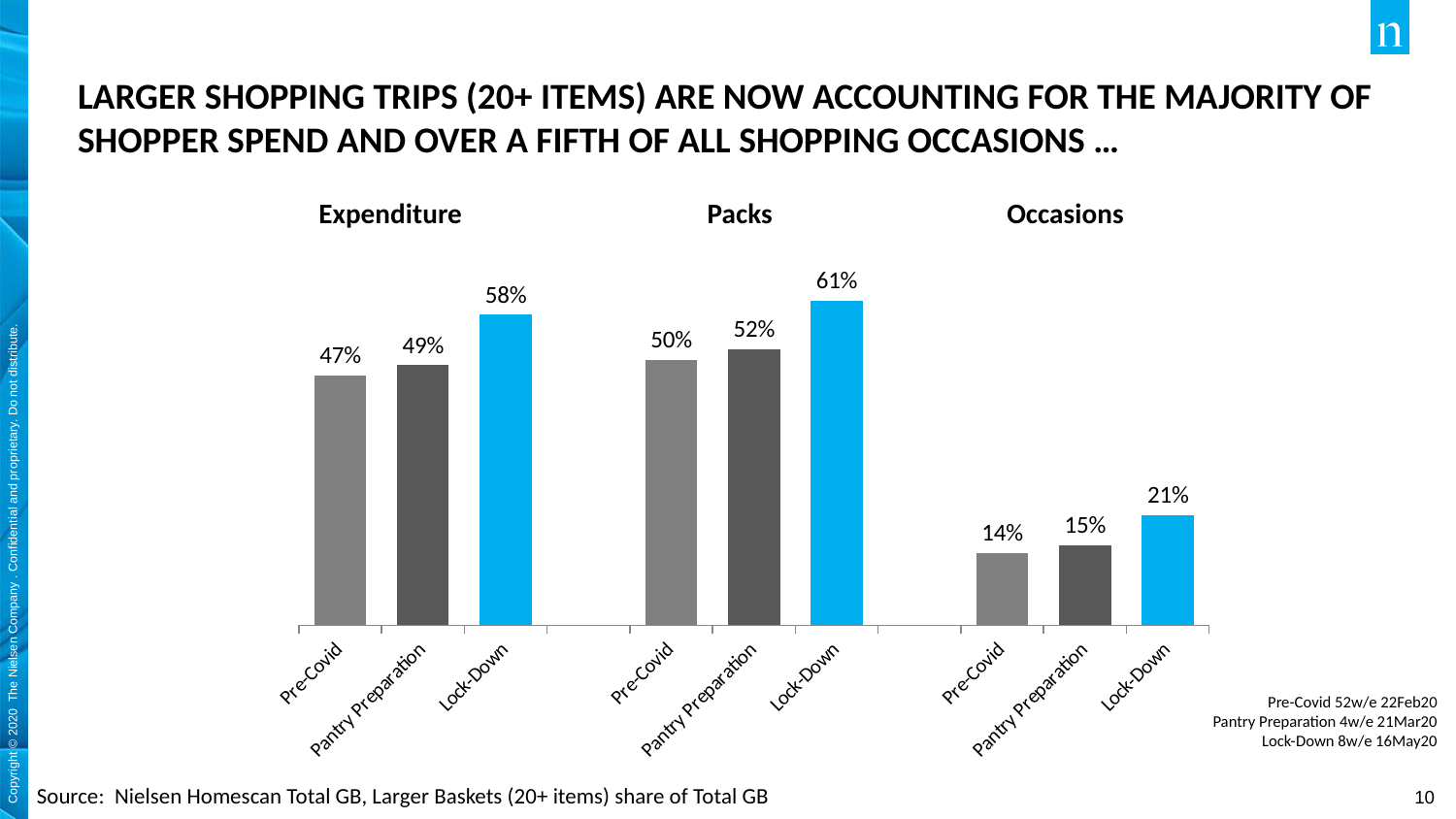
What is the Pre-Covid value in the Packs group? 50% What colour are the Lock-Down bars? Blue What is the difference between the Lock-Down and Pre-Covid values in the Packs group? 11% What is the difference between the Lock-Down and Pre-Covid values in the Occasions group? 7% What is the Pantry Preparation value in the Occasions group? 15% What kind of chart is shown on the slide? Bar chart Which period has the lowest value in the Expenditure group? Pre-Covid Which is larger: the Lock-Down value for Expenditure or the Lock-Down value for Packs? Packs What is the Lock-Down value in the Expenditure group? 58% Which period has the highest value in the Occasions group? Lock-Down How many bars are plotted on the chart in total? 9 Do the values rise or fall from Pre-Covid to Lock-Down in the Packs group? Rise